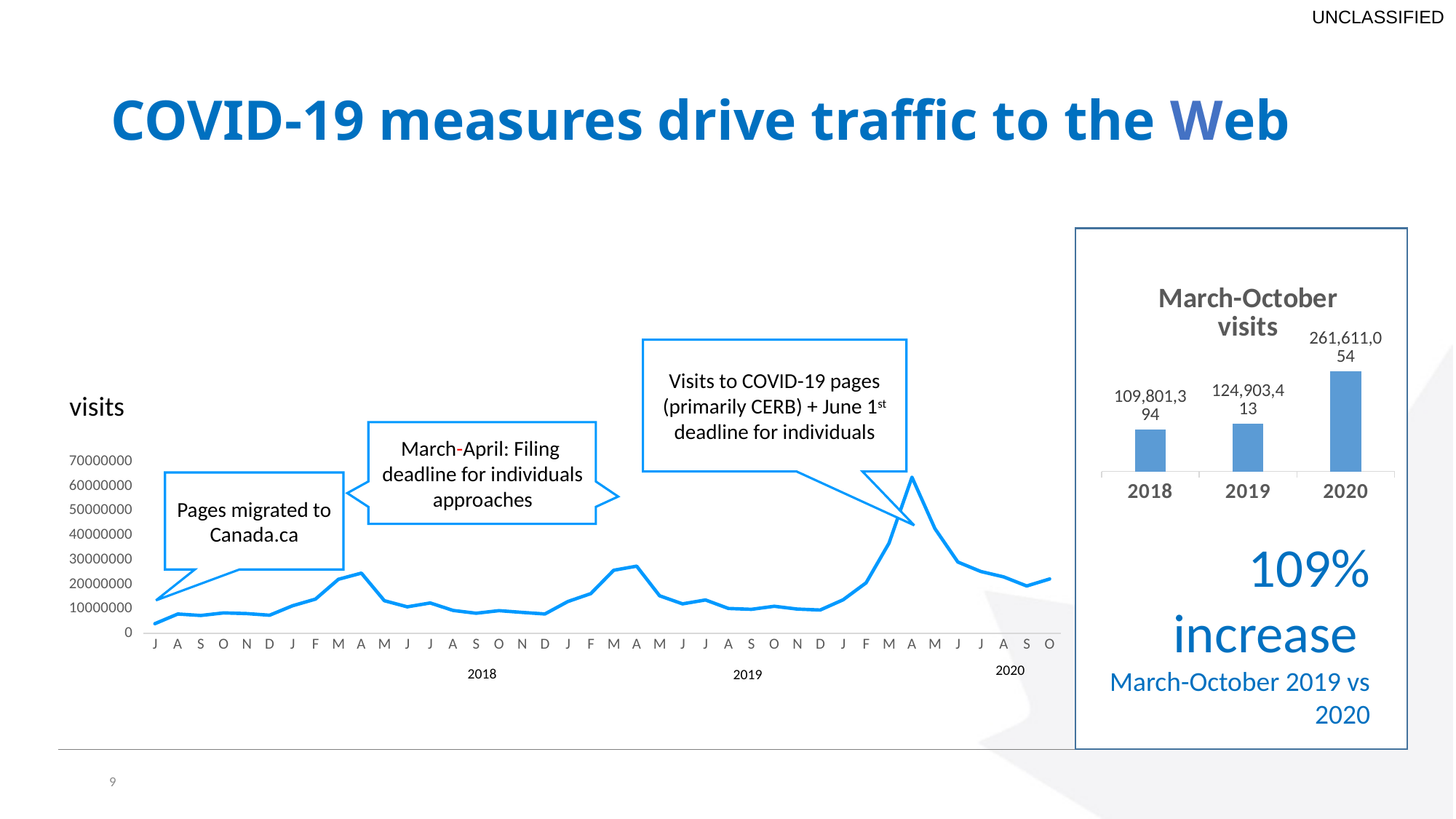
In the March-October visits bar chart, what is the value for 2018? 109,801,394 In the March-October visits bar chart, how many years are shown? 3 In the March-October visits bar chart, what is the value for 2020? 261,611,054 In the monthly visits line chart, do the values rise or fall from April 2020 to October 2020? fall What kind of chart is the large chart on the left showing monthly visits? line chart In the March-October visits bar chart, which year has the highest value? 2020 In the March-October visits bar chart, what is the difference between the 2019 and 2018 values? 15,102,019 In the March-October visits bar chart, what is the value for 2019? 124,903,413 In the March-October visits bar chart, what is the difference between the 2020 and 2019 values? 136,707,641 In the monthly visits line chart, is the peak value in April 2020 greater or less than 50000000? greater What kind of chart is the March-October visits chart on the right? bar chart In the March-October visits bar chart, which year has the lowest value? 2018